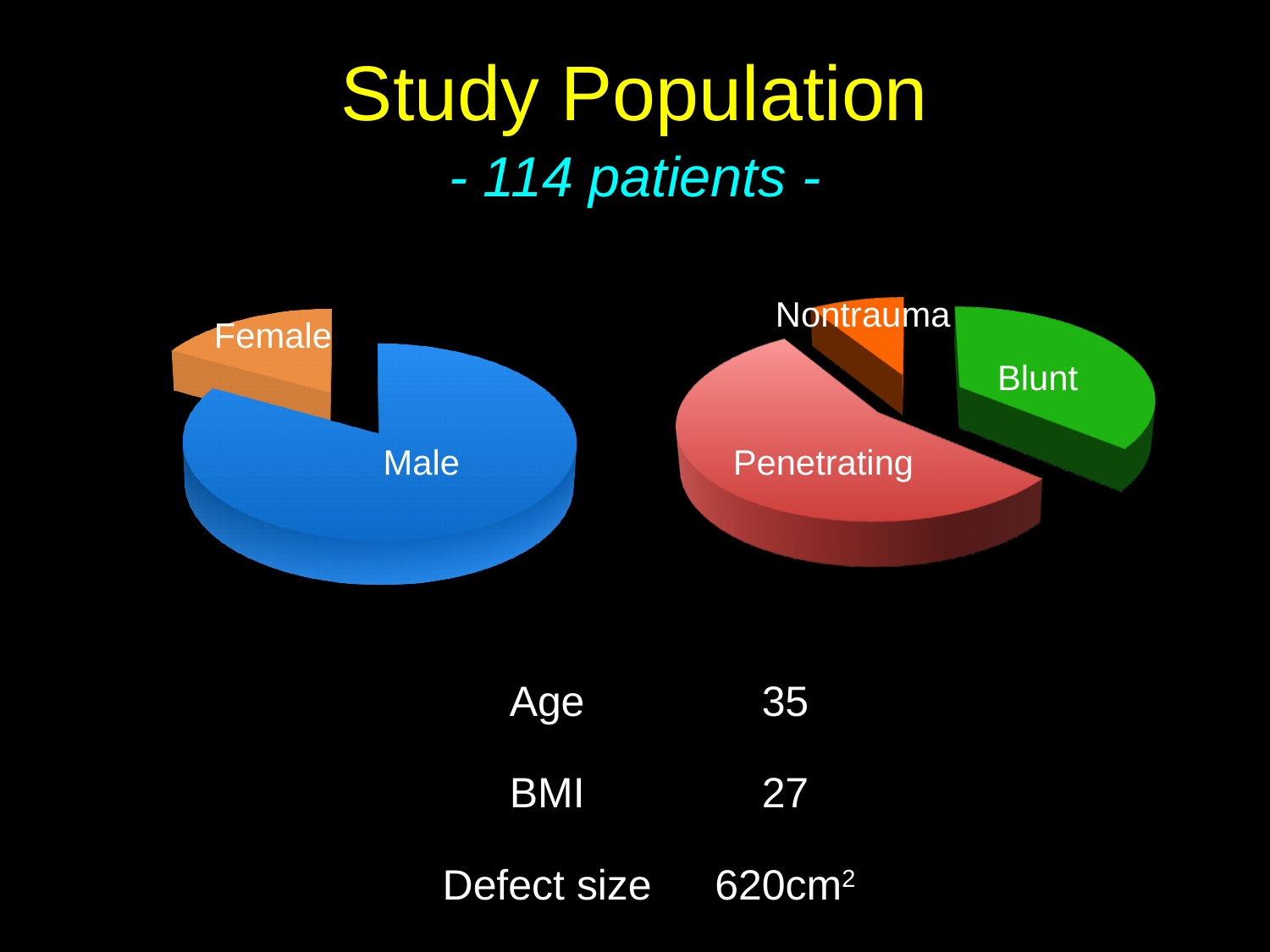
In the left pie chart, which slice is larger, Male or Female? Male In the left pie chart, what colour is the Female slice? orange What kind of chart is the right chart on the slide? pie chart How many slices does the right pie chart have? 3 In the right pie chart, which slice is larger, Blunt or Nontrauma? Blunt What kind of chart is the left chart on the slide? pie chart In the right pie chart, what colour is the Blunt slice? green In the right pie chart, which category has the largest slice? Penetrating In the left pie chart, which category has the smallest slice? Female How many slices does the left pie chart have? 2 In the left pie chart, which category has the largest slice? Male In the right pie chart, which category has the smallest slice? Nontrauma